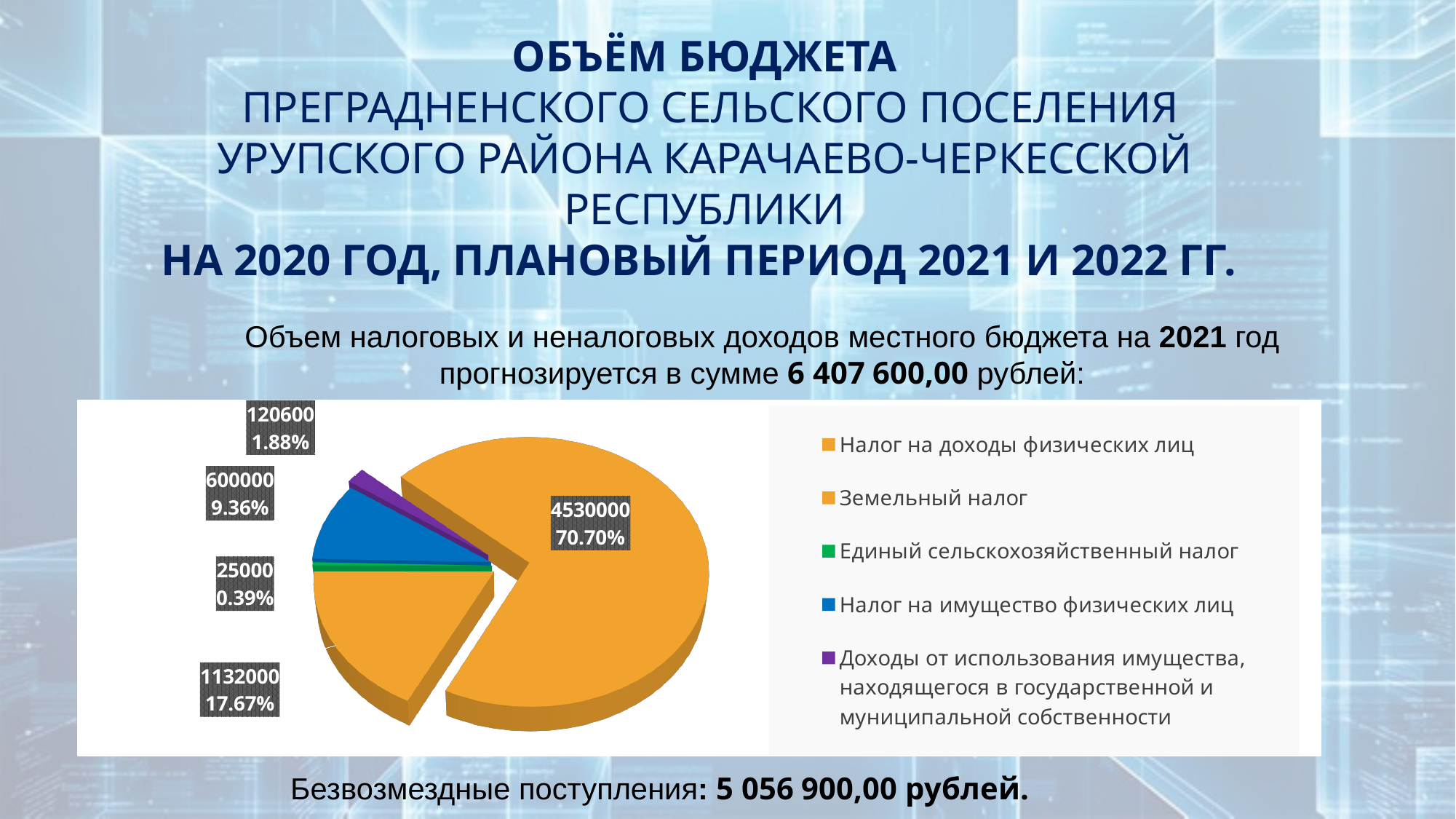
Which slice of the pie chart is the smallest? 25000 (0.39%) What percentage share is shown for the slice with value 1132000? 17.67% What value is shown for the slice with share 9.36%? 600000 What value is shown for the slice labelled 70.70%? 4530000 Which legend entry is marked with a blue square? Налог на имущество физических лиц How many entries does the legend of the pie chart list? 5 Which slice of the pie chart is the largest? 4530000 (70.70%) What percentage share is shown for the slice with value 25000? 0.39% What type of chart is shown on the slide? Pie chart What percentage share is shown for the slice with value 120600? 1.88% What is the difference between the values 4530000 and 1132000 shown on the pie chart? 3398000 How many slices does the pie chart have? 5